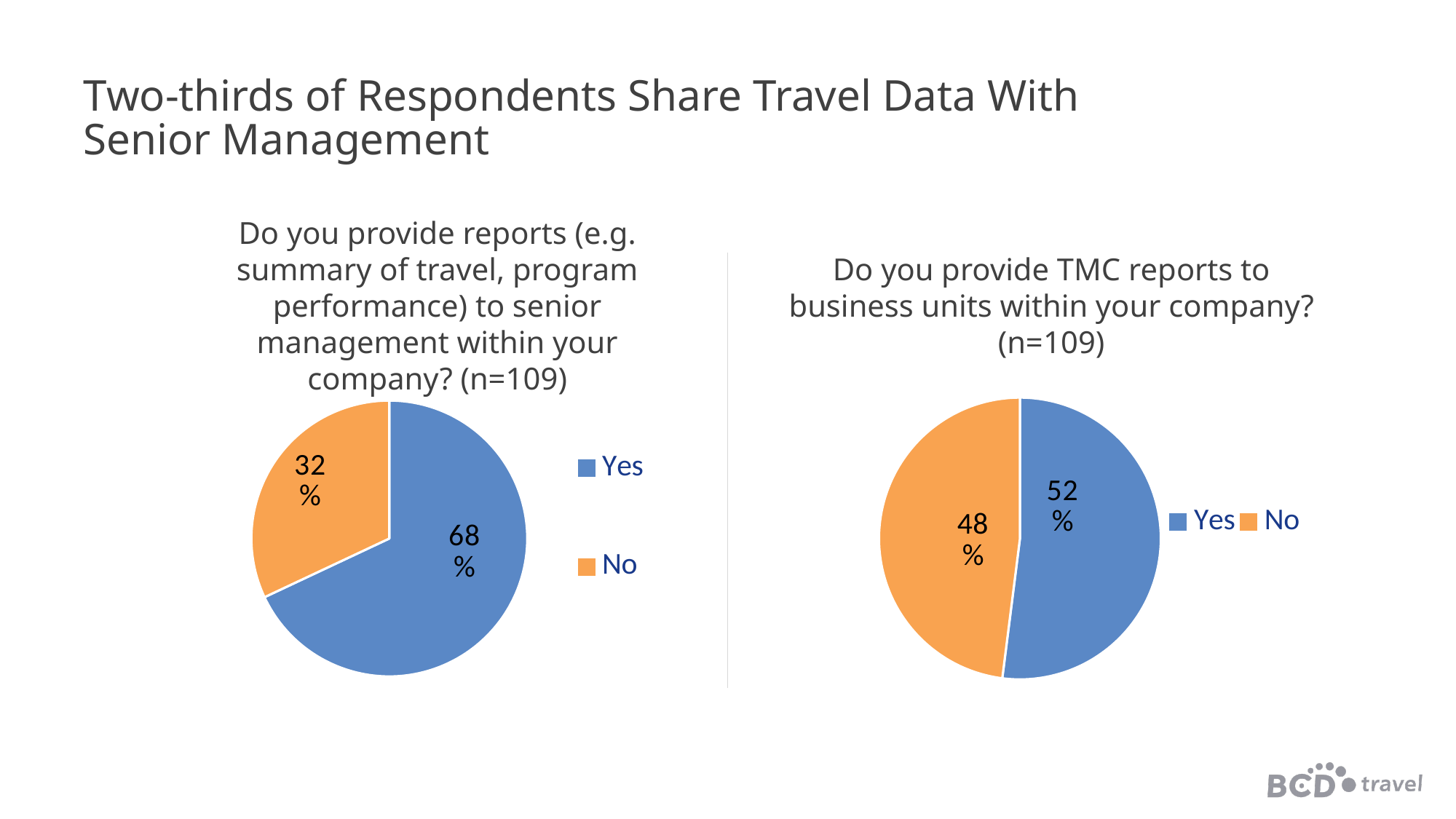
In the left pie chart (reports to senior management), what percentage of respondents answered Yes? 68% In the left pie chart (reports to senior management), which response has the largest share? Yes In the right pie chart (TMC reports to business units), which response has the smallest share? No In the right pie chart (TMC reports to business units), what is the difference in percentage points between Yes and No? 4 Is the Yes share larger in the left pie chart (senior management) or the right pie chart (business units)? Left pie chart In the left pie chart (reports to senior management), what is the difference in percentage points between Yes and No? 36 In the left pie chart (reports to senior management), what percentage of respondents answered No? 32% In the left pie chart (reports to senior management), what colour represents the No response? Orange In the right pie chart (TMC reports to business units), what percentage of respondents answered No? 48% How many slices does the right pie chart (TMC reports to business units) have? 2 What type of chart is used on this slide? Pie chart In the right pie chart (TMC reports to business units), what percentage of respondents answered Yes? 52%